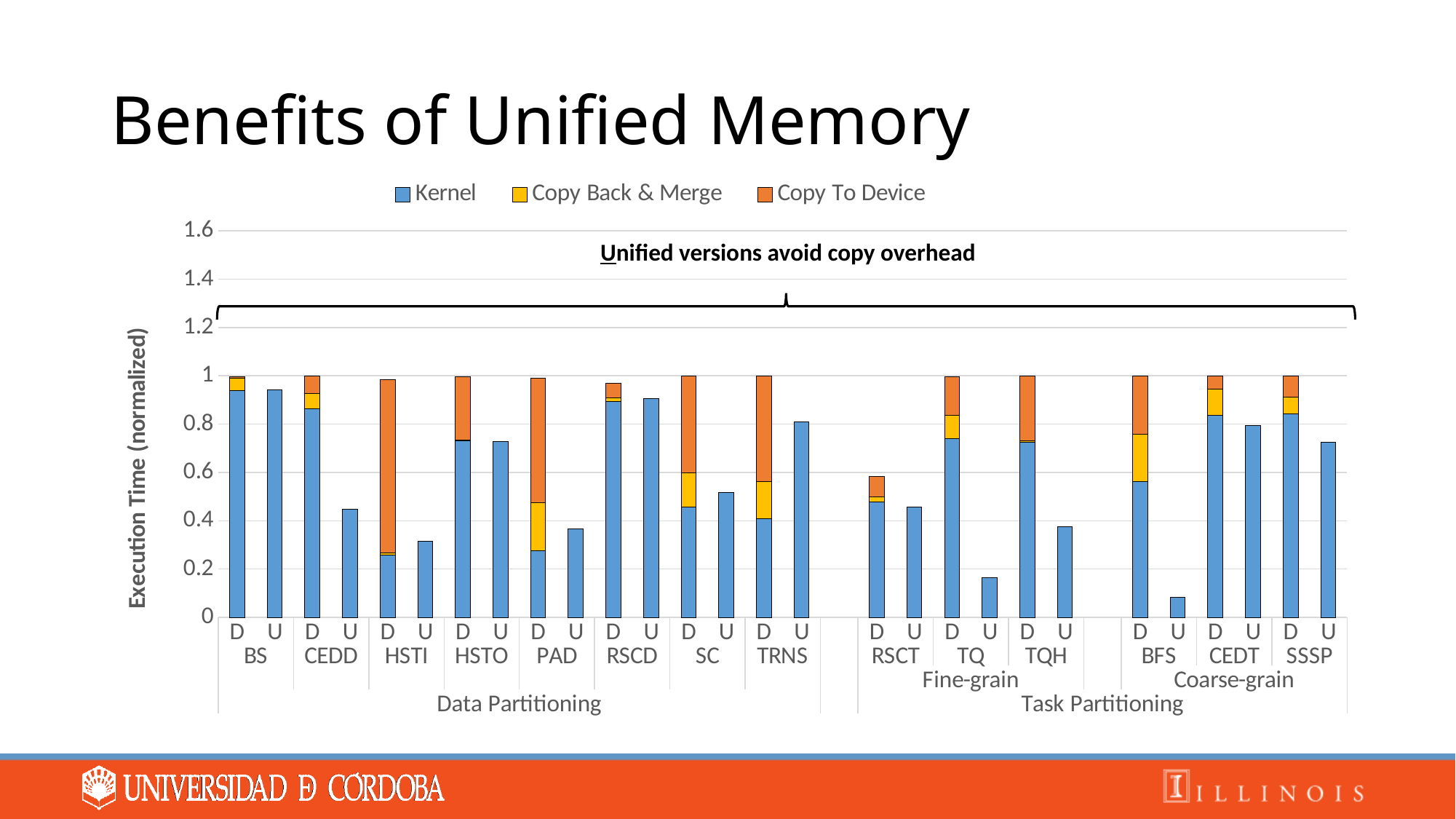
Which is larger, the BS U bar or the CEDD U bar? BS U Is the value for the BS U bar greater or less than 0.8? greater How many benchmarks (category groups with D and U bars) are shown on the x axis? 14 Is the value for the BFS U bar greater or less than 0.2? less Among the D bars, which benchmark has the lowest D bar? RSCT What kind of chart is shown on the slide? Stacked bar chart What is the label of the y axis? Execution Time (normalized) Which is larger, the TQ U bar or the BFS U bar? TQ U Is the value for the CEDD U bar greater or less than 0.4? greater Which bar is the lowest in the chart? BFS U How many series does the legend list? 3 Which series are listed in the legend? Kernel, Copy Back & Merge, Copy To Device